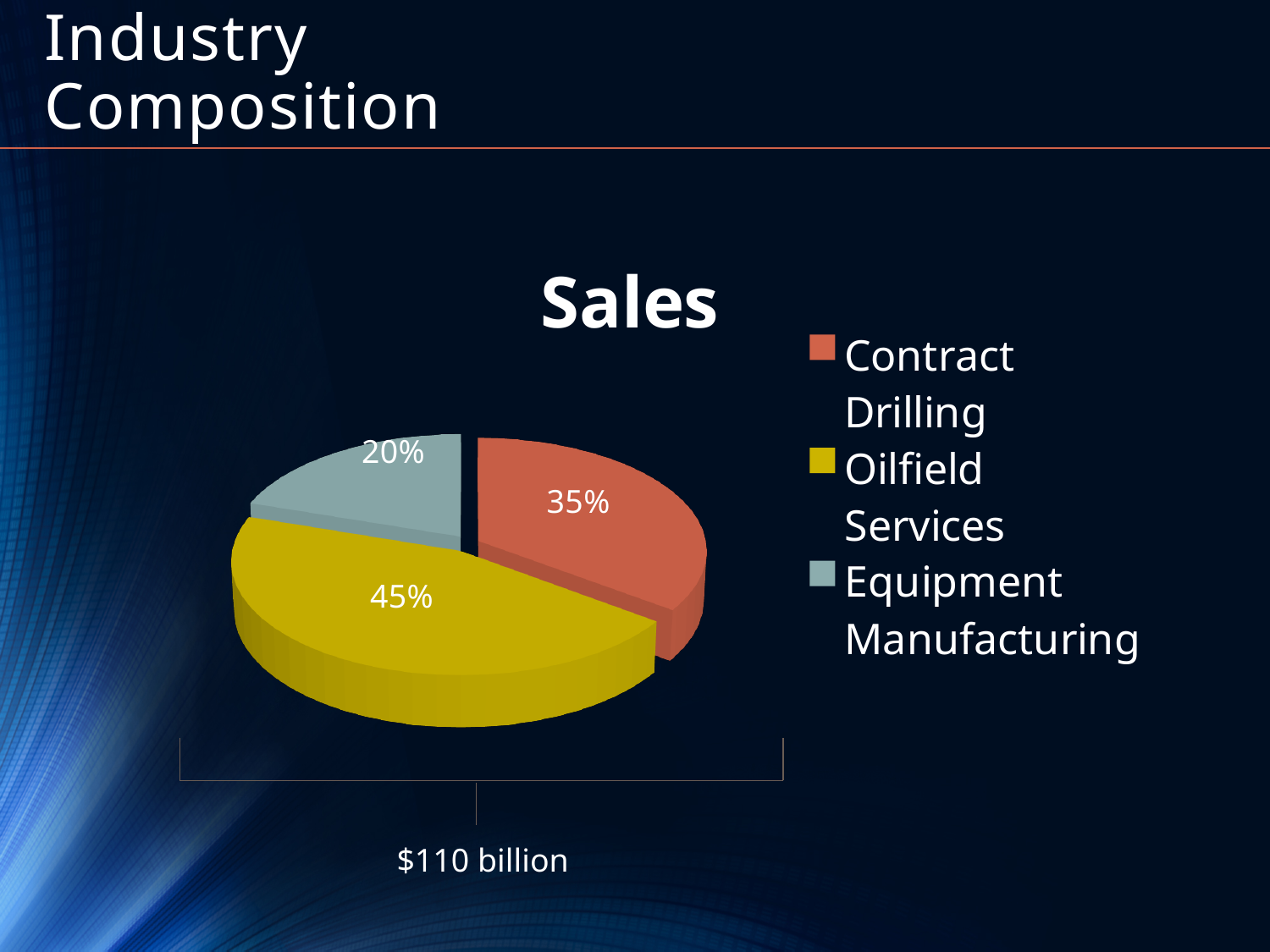
What is the difference in percentage points between the Contract Drilling and Equipment Manufacturing shares? 15 percentage points What share of sales does Contract Drilling account for? 35% What total sales figure is shown beneath the chart? $110 billion What share of sales does Oilfield Services account for? 45% What is the difference in percentage points between the Oilfield Services and Contract Drilling shares? 10 percentage points Which is larger, the share for Contract Drilling or the share for Equipment Manufacturing? Contract Drilling Which segment has the largest share of sales? Oilfield Services Which segment has the smallest share of sales? Equipment Manufacturing What kind of chart is shown on the slide? Pie chart What share of sales does Equipment Manufacturing account for? 20% What is the title of the chart? Sales How many segments does the pie chart have? 3